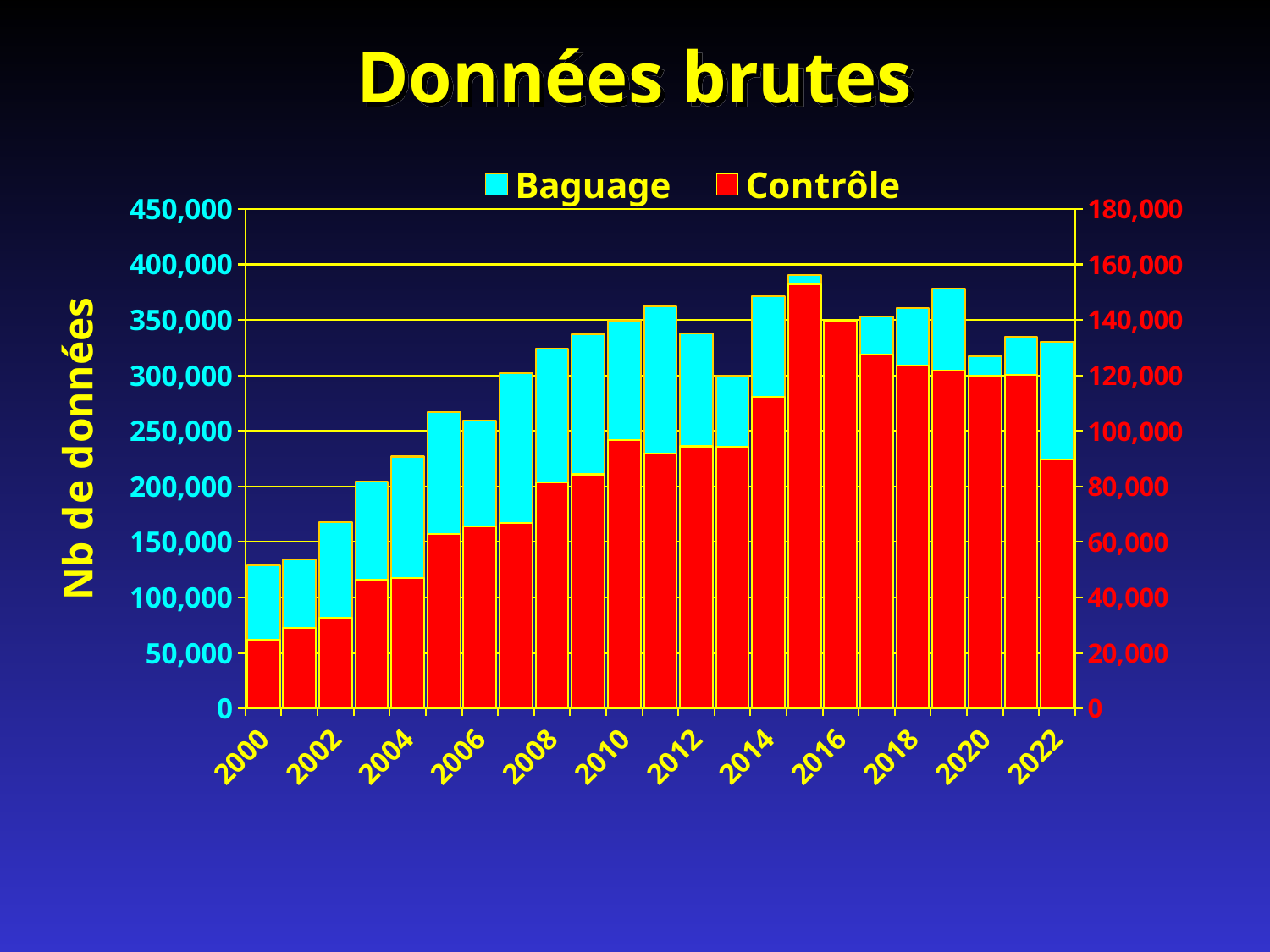
Which year has the taller overall bar, 2000 or 2015? 2015 Do the Contrôle (red) bars generally rise or fall from 2000 to 2015? rise Which year has the taller Contrôle (red) bar, 2021 or 2022? 2021 How many years (bars) are plotted along the x axis? 23 In which year is the Contrôle (red) bar the highest? 2015 In which year is the Contrôle (red) bar the lowest? 2000 How many series does the legend list? 2 Is the Contrôle (red) value for 2015 greater or less than 140,000 on the right axis? greater What is the title of the chart? Données brutes What are the two series named in the legend? Baguage and Contrôle Is the Contrôle (red) value for 2022 greater or less than 100,000 on the right axis? less What kind of chart is shown on the slide? bar chart